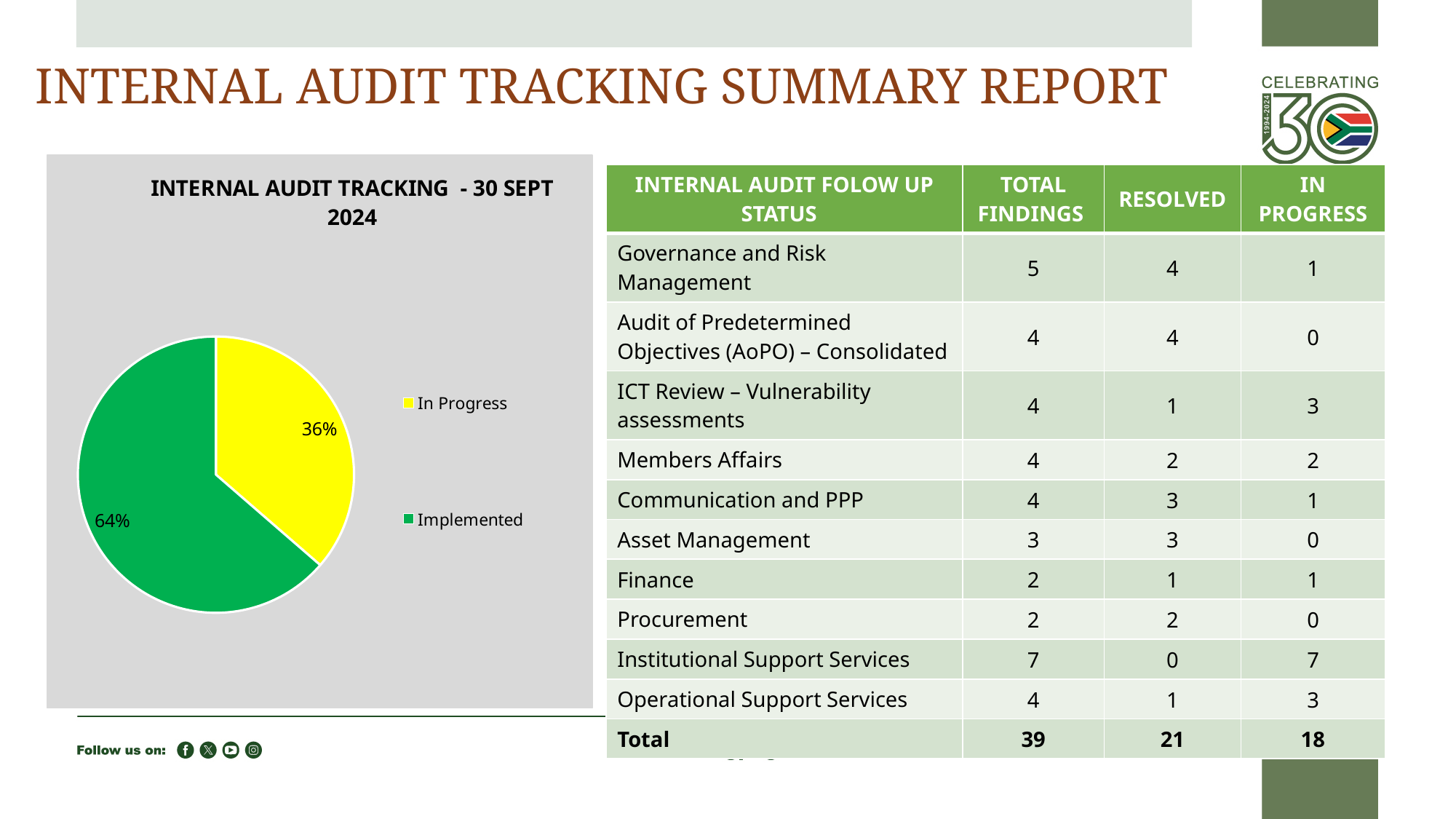
Which is larger, the Implemented slice or the In Progress slice? Implemented What colour is the In Progress slice of the pie? Yellow What share of the pie is labelled Implemented? 64% Which slice of the pie is the largest? Implemented How many entries does the chart legend list? 2 How many slices does the pie chart have? 2 What is the title of the chart? INTERNAL AUDIT TRACKING - 30 SEPT 2024 What is the difference in percentage points between the Implemented and In Progress slices? 28% What share of the pie is labelled In Progress? 36% Is the Implemented share greater or less than 50%? greater Which slice of the pie is the smallest? In Progress What kind of chart is shown on the slide? Pie chart